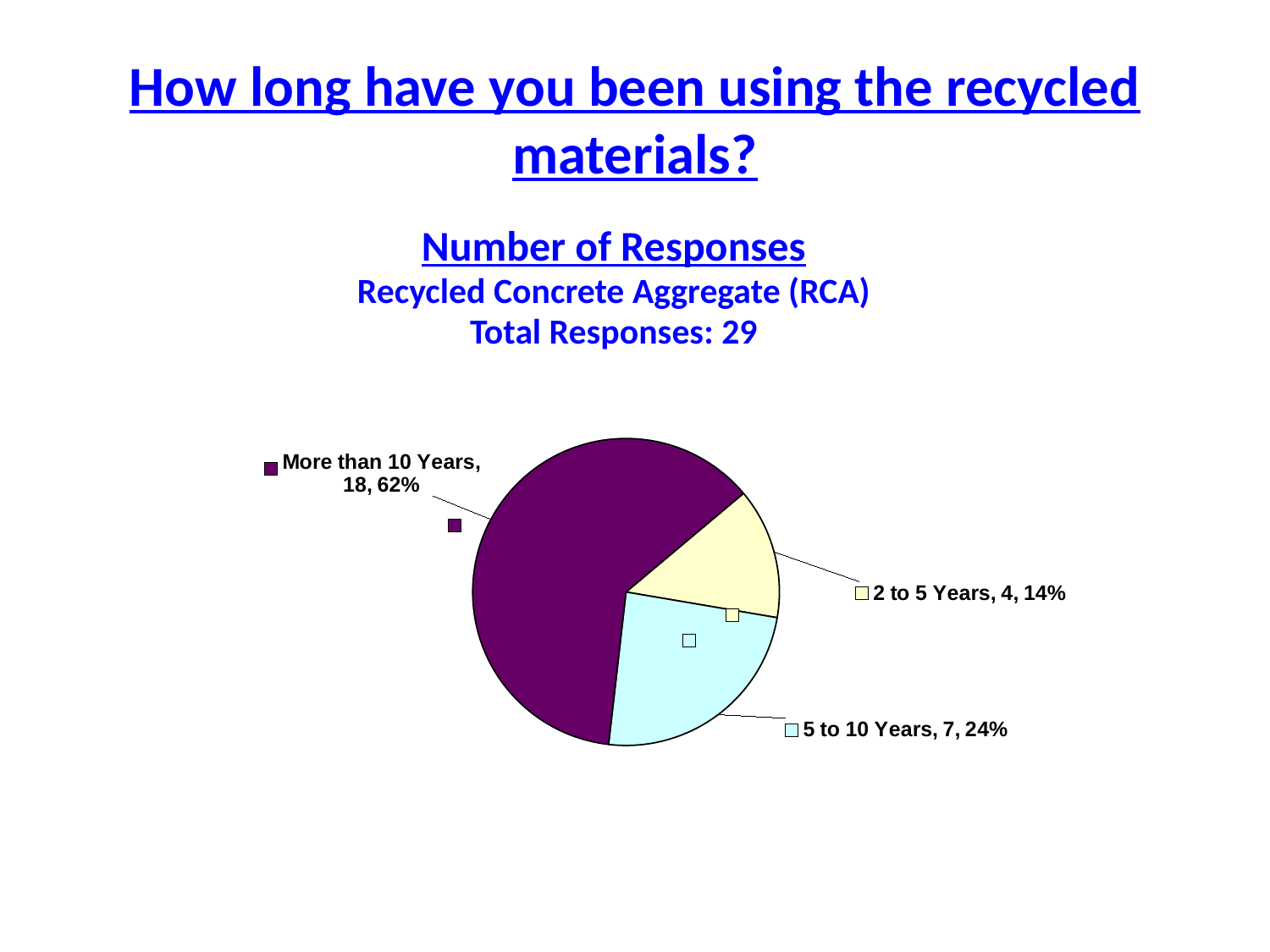
What is the total number of responses stated on the slide? 29 What percentage share does the 'More than 10 Years' slice have? 62% How many responses are in the '5 to 10 Years' slice? 7 How many responses are in the '2 to 5 Years' slice? 4 Which category has the smallest number of responses? 2 to 5 Years How many slices does the pie chart have? 3 What is the difference in responses between 'More than 10 Years' and '5 to 10 Years'? 11 Which category has the largest number of responses? More than 10 Years What kind of chart is shown on the slide? pie chart How many responses are in the 'More than 10 Years' slice? 18 What percentage share does the '2 to 5 Years' slice have? 14% Which has more responses, '5 to 10 Years' or '2 to 5 Years'? 5 to 10 Years